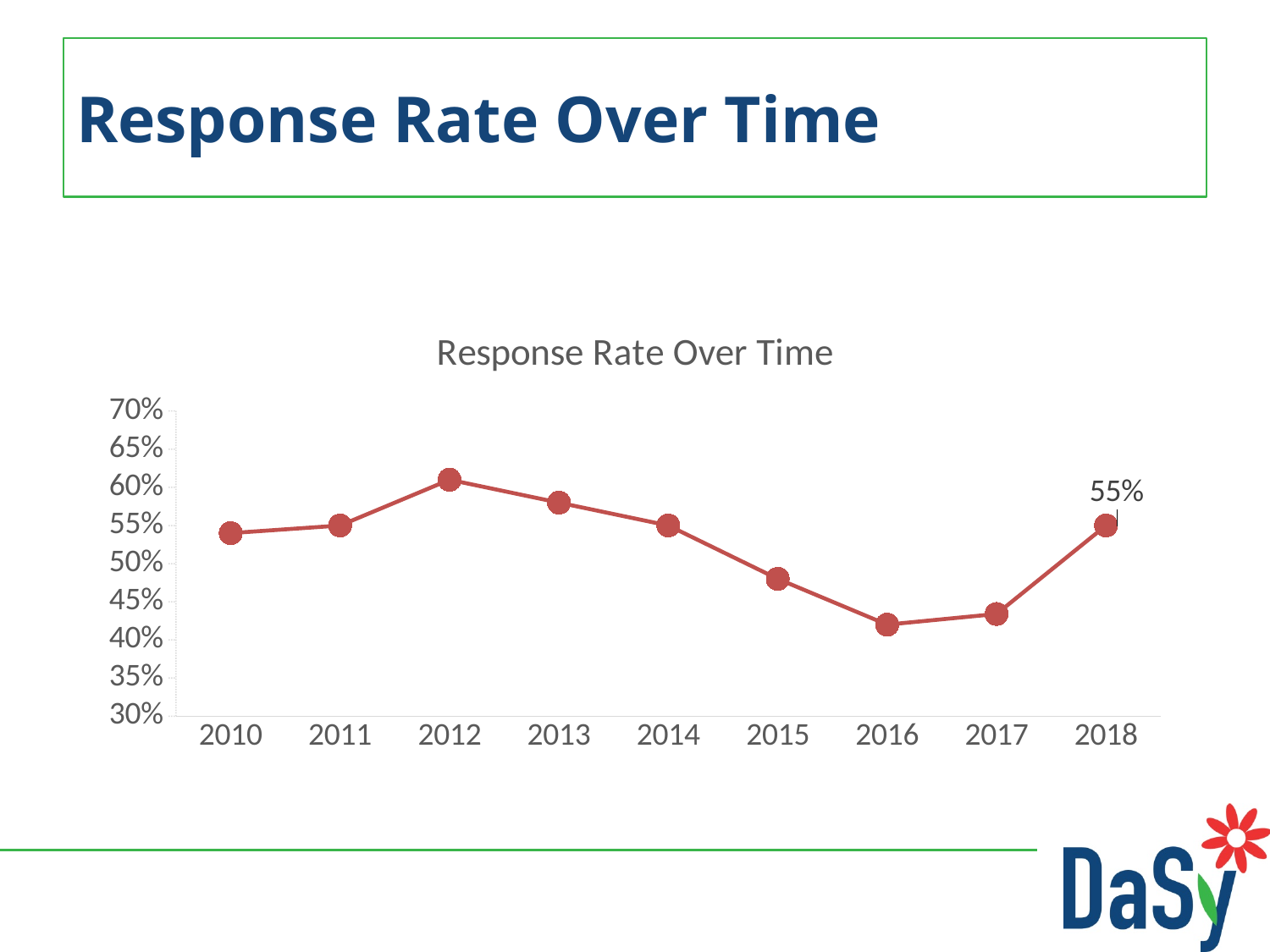
Is the response rate for 2015 greater or less than 50%? less What is the title of the chart? Response Rate Over Time Is the response rate for 2012 greater or less than 55%? greater Which year has the larger response rate, 2012 or 2016? 2012 What is the response rate for 2018? 55% What kind of chart is shown on the slide? Line chart Which year has the larger response rate, 2013 or 2015? 2013 How many years are plotted on the chart? 9 Is the response rate for 2016 greater or less than 45%? less Which year has the highest response rate? 2012 Does the response rate rise or fall from 2012 to 2016? Fall